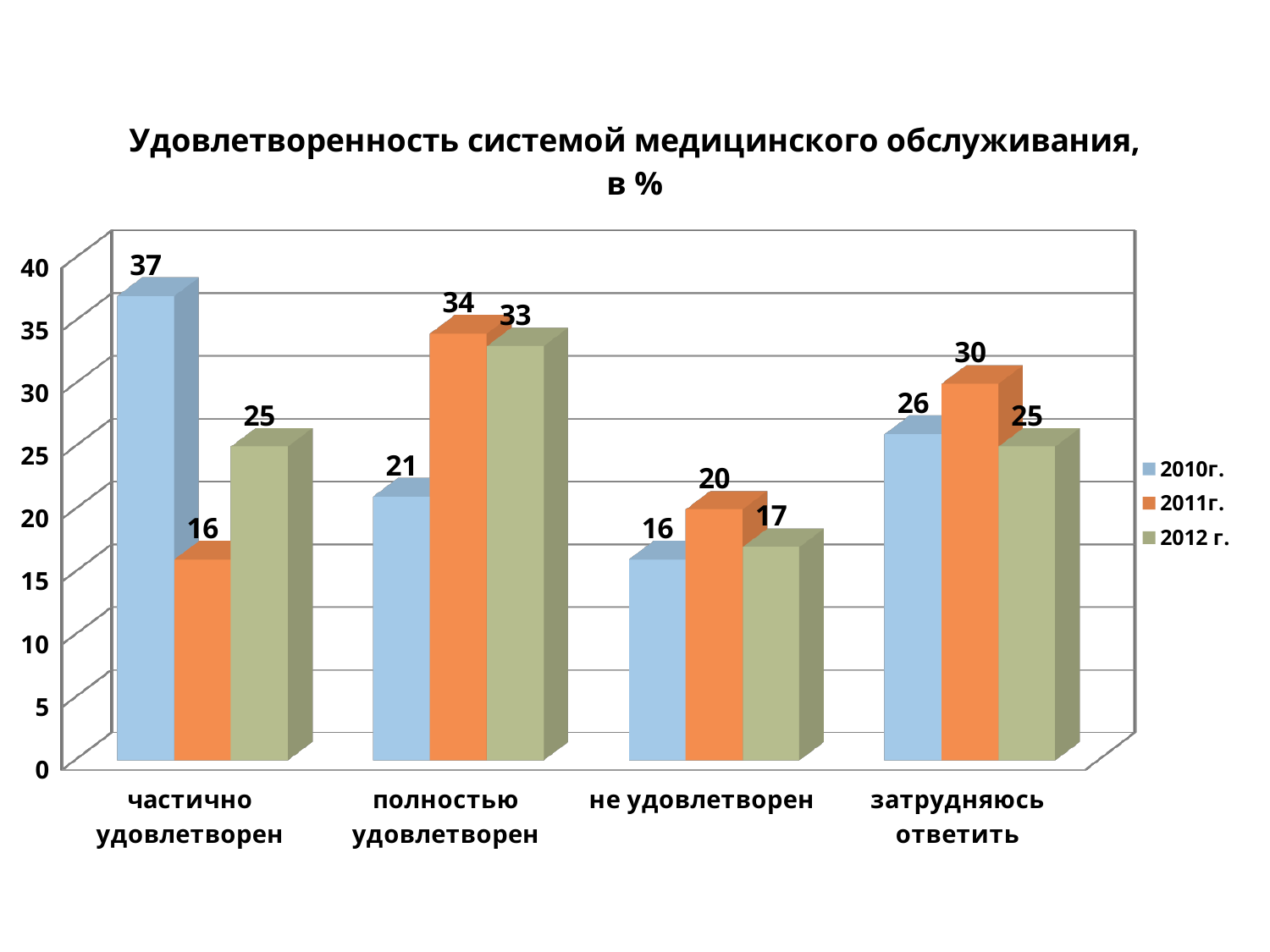
What is the value for 2011г. in the 'затрудняюсь ответить' category? 30 Which category has the lowest value for the 2011г. series? частично удовлетворен What is the value for 2010г. in the 'частично удовлетворен' category? 37 How many series does the legend list? 3 How many categories are shown on the x axis? 4 Which is larger in the 'полностью удовлетворен' category: the 2010г. value or the 2012 г. value? 2012 г. What is the value for 2011г. in the 'полностью удовлетворен' category? 34 What is the title of the chart? Удовлетворенность системой медицинского обслуживания, в % What kind of chart is shown on the slide? bar chart What is the difference between the 2010г. and 2011г. values in the 'частично удовлетворен' category? 21 Which category has the highest value for the 2010г. series? частично удовлетворен What is the value for 2012 г. in the 'не удовлетворен' category? 17